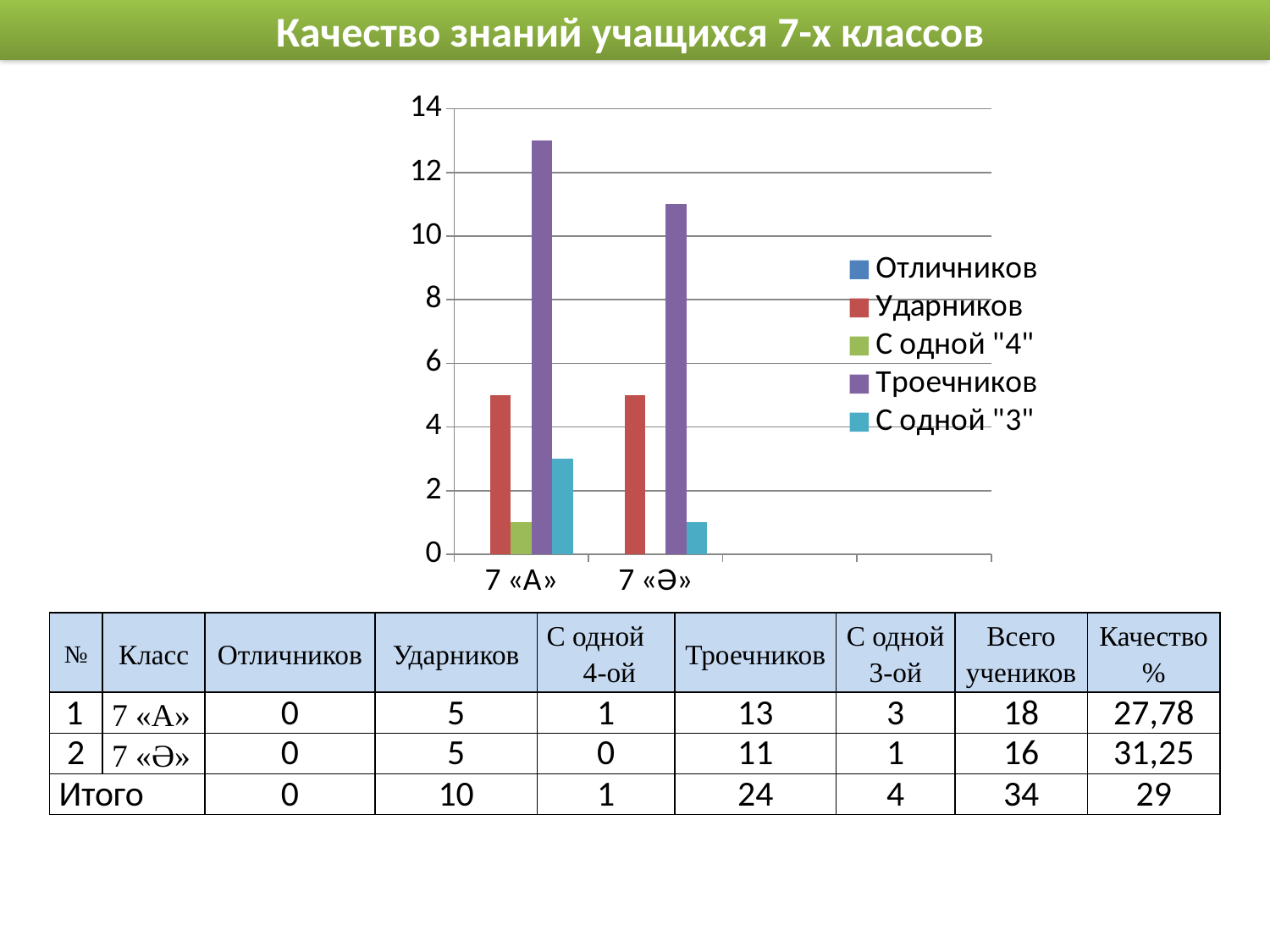
Which class has the taller Троечников bar, 7 «А» or 7 «Ә»? 7 «А» Which class has the taller С одной "3" bar, 7 «А» or 7 «Ә»? 7 «А» How many series does the chart legend list? 5 How many classes (categories) are plotted on the x axis of the chart? 2 Is the Троечников bar for 7 «А» greater or less than 12? greater According to the slide, how many Ударников are in class 7 «Ә»? 5 According to the slide, how many Троечников are in class 7 «А»? 13 What kind of chart is shown on the slide? bar chart Is the Троечников bar for 7 «Ә» greater or less than 12? less What colour are the Троечников bars in the chart? purple What is the difference between the number of Троечников in 7 «А» and in 7 «Ә»? 2 Which series has the tallest bar for class 7 «А»? Троечников